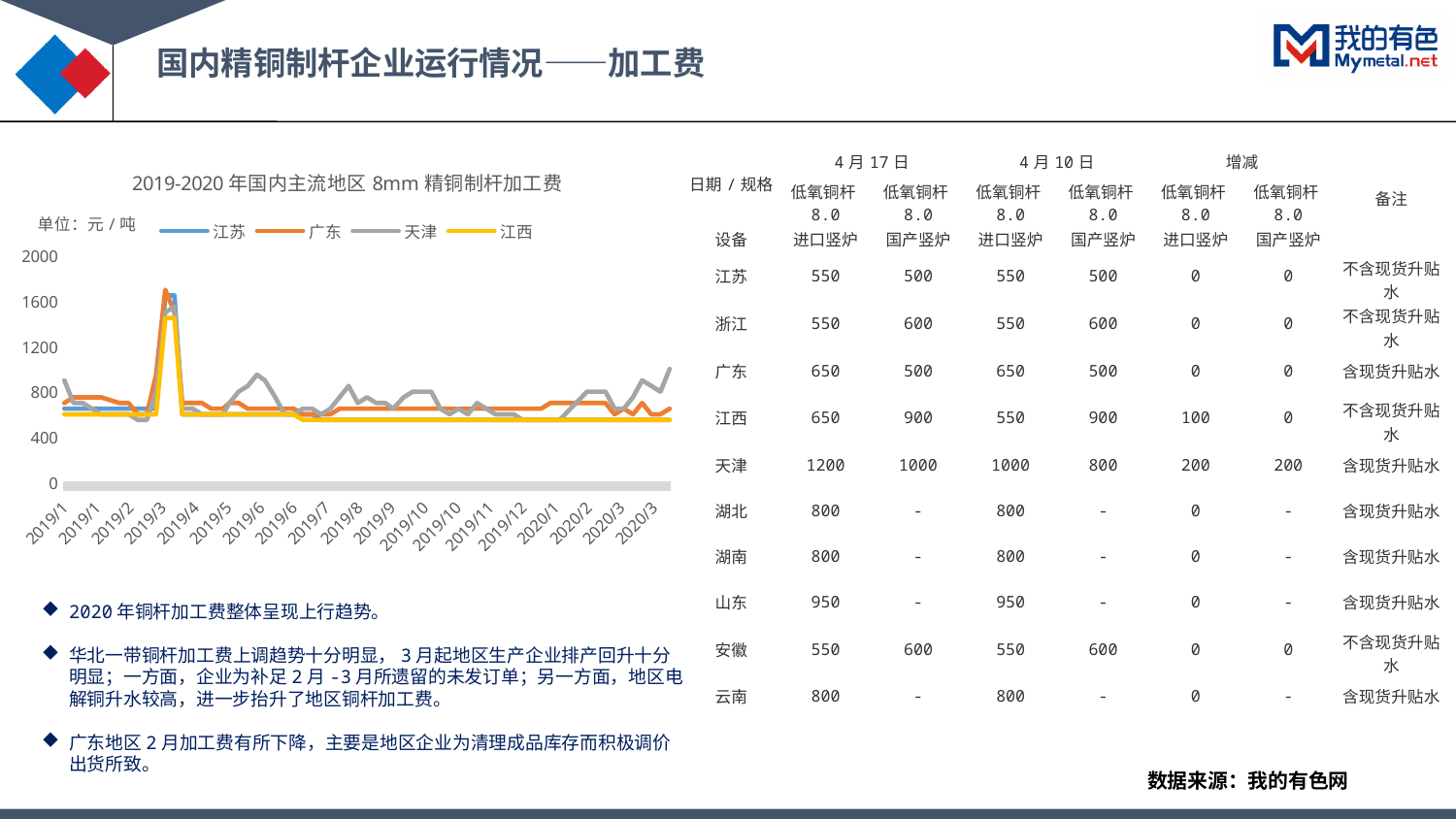
What is the title of the line chart? 2019-2020年国内主流地区8mm精铜制杆加工费 How many series does the legend of the line chart list? 4 In the line chart, is the value for 广东 at 2019/12 greater or less than 1200? less In the line chart, is the peak value for 广东 around 2019/3 greater or less than 1200? greater In the line chart, is the value for 江苏 at 2019/1 greater or less than 800? less What kind of chart is shown on the left of the slide? line chart What is the highest value shown on the y axis of the line chart? 2000 What unit is shown for the values in the line chart? 元/吨 In the line chart, do the values for 广东 rise or fall between 2019/3 and 2019/4? fall